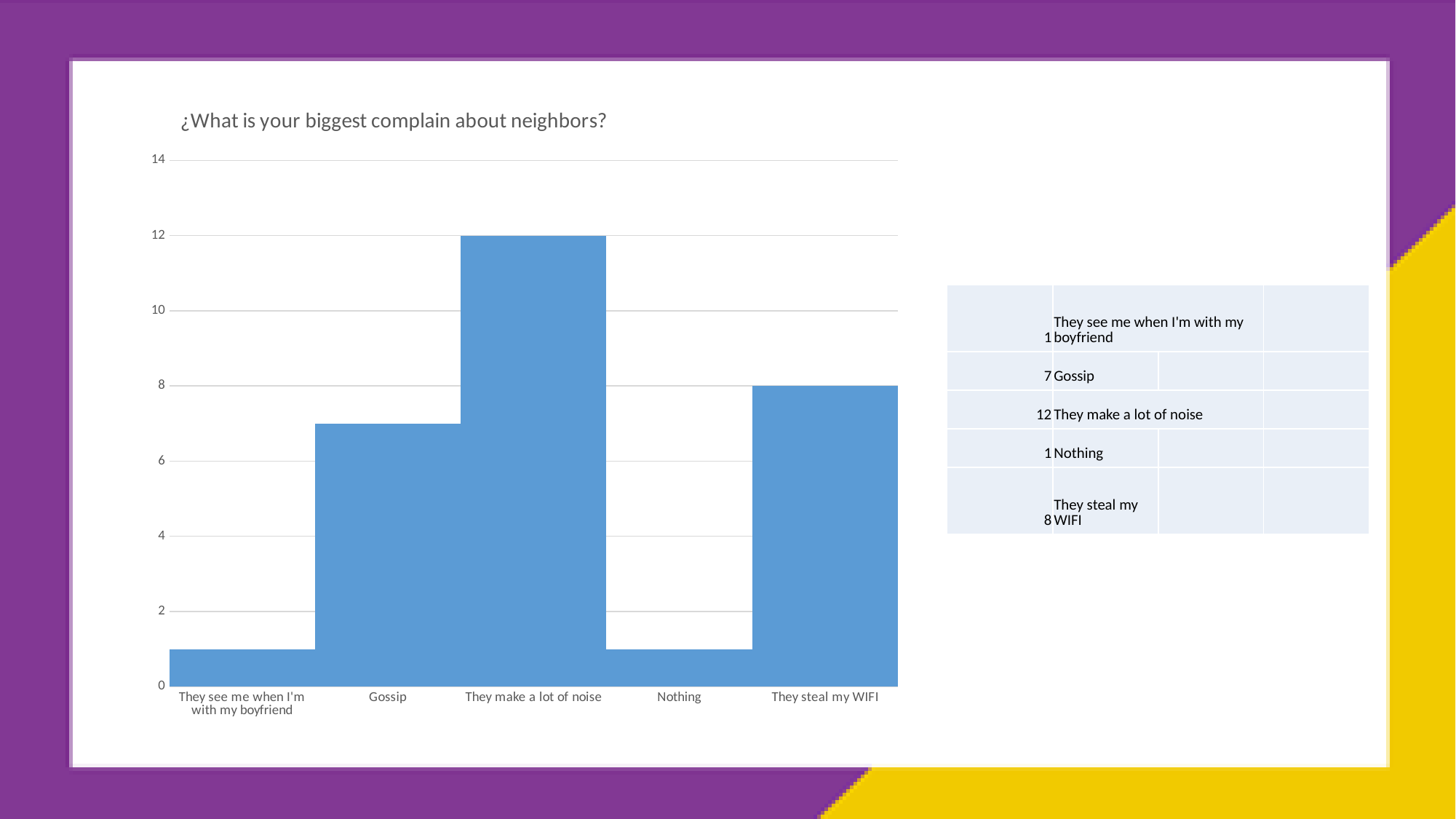
Which category has the highest value? They make a lot of noise What is the title of the chart? ¿What is your biggest complain about neighbors? What is the value for "Gossip"? 7 What is the difference between the values for "They make a lot of noise" and "They steal my WIFI"? 4 What is the value for "They make a lot of noise"? 12 How many categories are shown on the x axis? 5 Which is larger, the value for "Gossip" or the value for "They steal my WIFI"? They steal my WIFI What kind of chart is shown on the slide? bar chart What is the difference between the values for "Gossip" and "Nothing"? 6 What is the value for "Nothing"? 1 What is the value for "They steal my WIFI"? 8 Is the value for "Gossip" greater or less than 6? greater